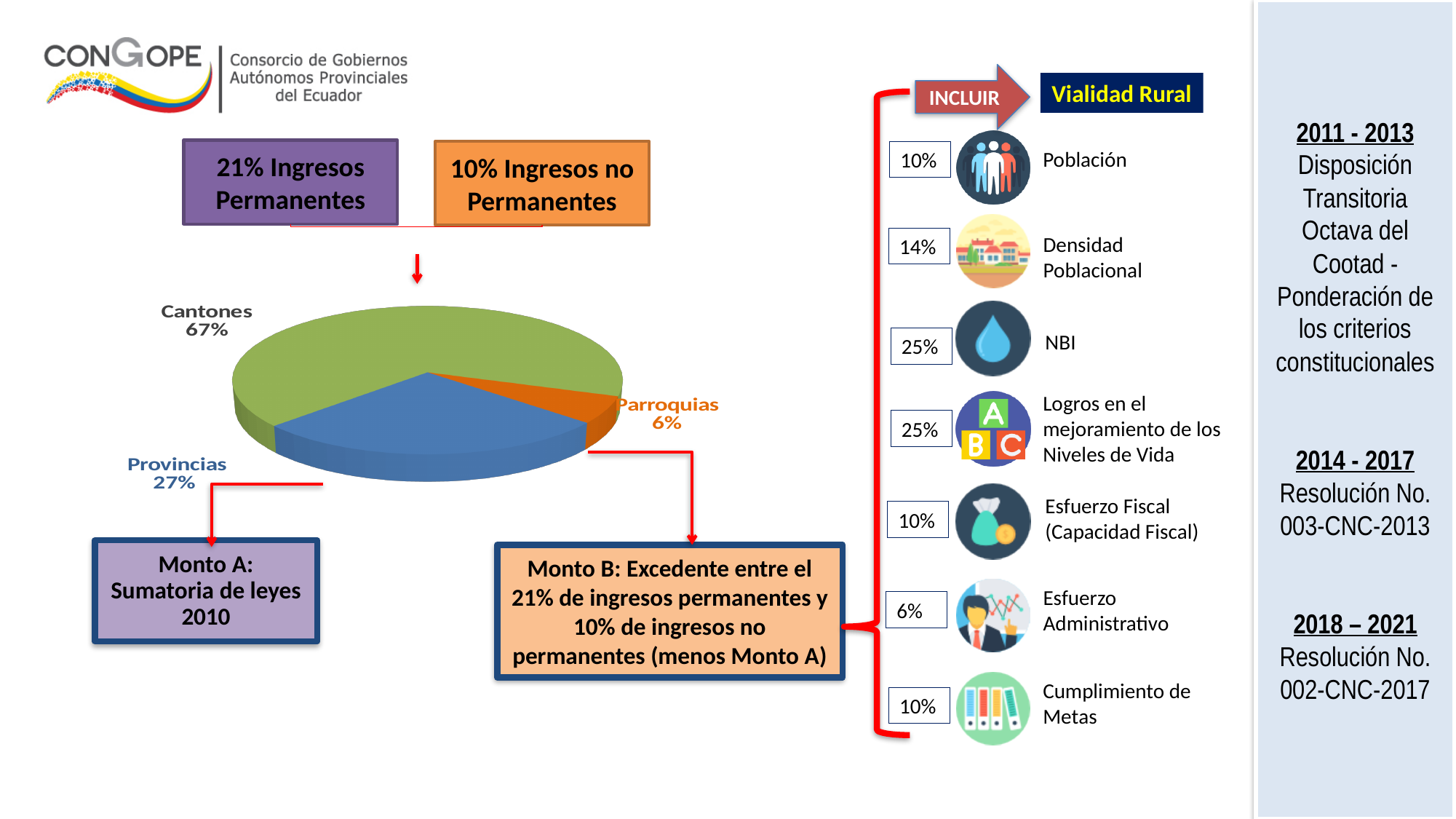
Which slice of the pie chart is the largest? Cantones What percentage does the pie chart show for Provincias? 27% What percentage does the pie chart show for Cantones? 67% What colour is the Cantones slice of the pie chart? green What is the difference in percentage points between the Provincias and Parroquias slices? 21 Which slice of the pie chart is the smallest? Parroquias Which is larger in the pie chart, Provincias or Parroquias? Provincias What percentage does the pie chart show for Parroquias? 6% What colour is the Provincias slice of the pie chart? blue What is the difference in percentage points between the Cantones and Provincias slices? 40 What kind of chart is shown on the slide? pie chart How many slices does the pie chart have? 3